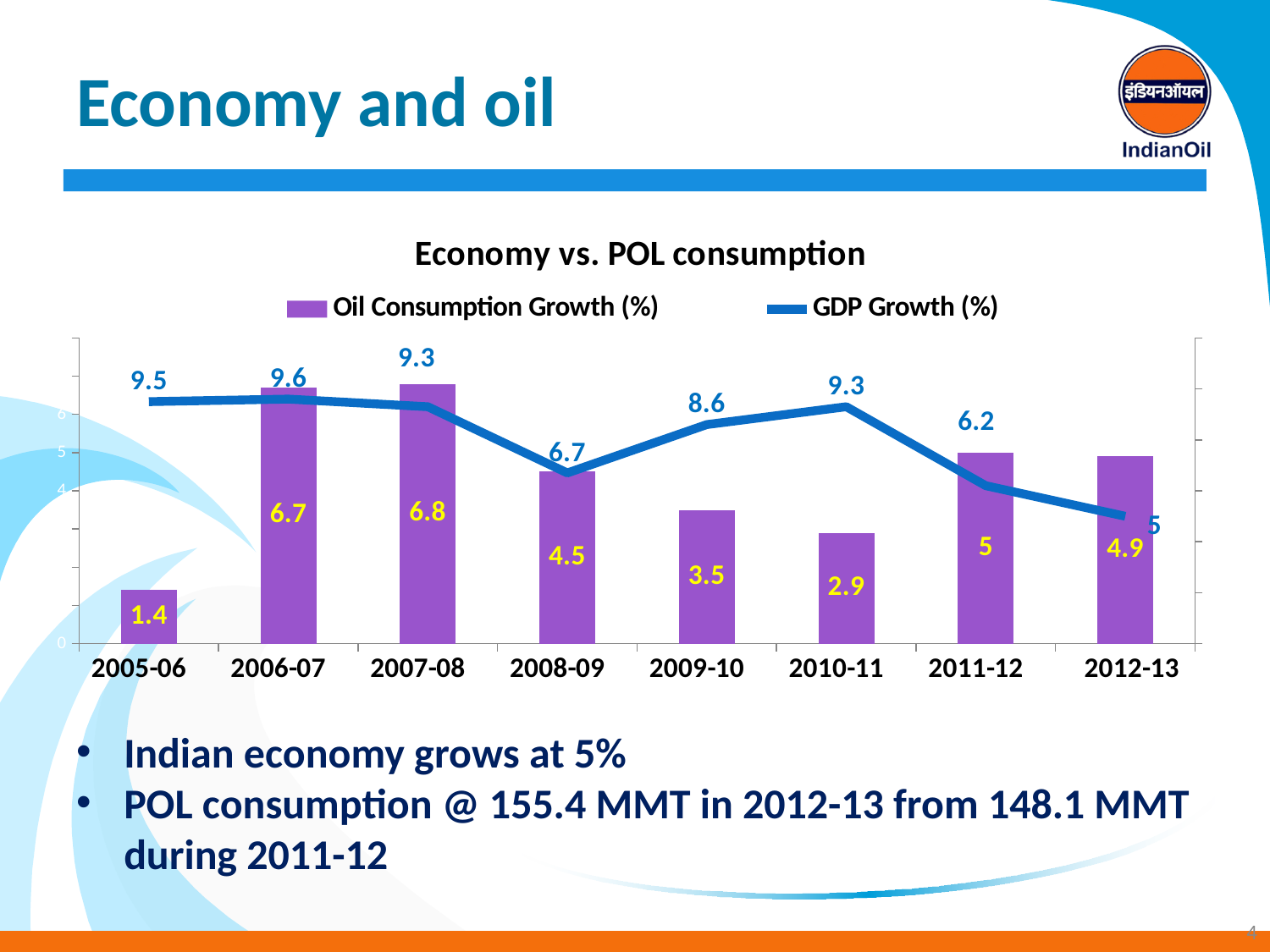
What is the difference between GDP Growth (%) and Oil Consumption Growth (%) in 2008-09? 2.2 What is the title of the chart? Economy vs. POL consumption How many fiscal years are shown on the x axis of the chart? 8 Which year has the lowest Oil Consumption Growth (%)? 2005-06 What is the GDP Growth (%) value for 2009-10? 8.6 What is the Oil Consumption Growth (%) value for 2010-11? 2.9 Which year has the highest GDP Growth (%)? 2006-07 How many series does the chart's legend list? 2 In 2011-12, which is larger: GDP Growth (%) or Oil Consumption Growth (%)? GDP Growth (%) Which year has the lowest GDP Growth (%)? 2012-13 What is the Oil Consumption Growth (%) value for 2005-06? 1.4 Does GDP Growth (%) rise or fall from 2010-11 to 2012-13? fall